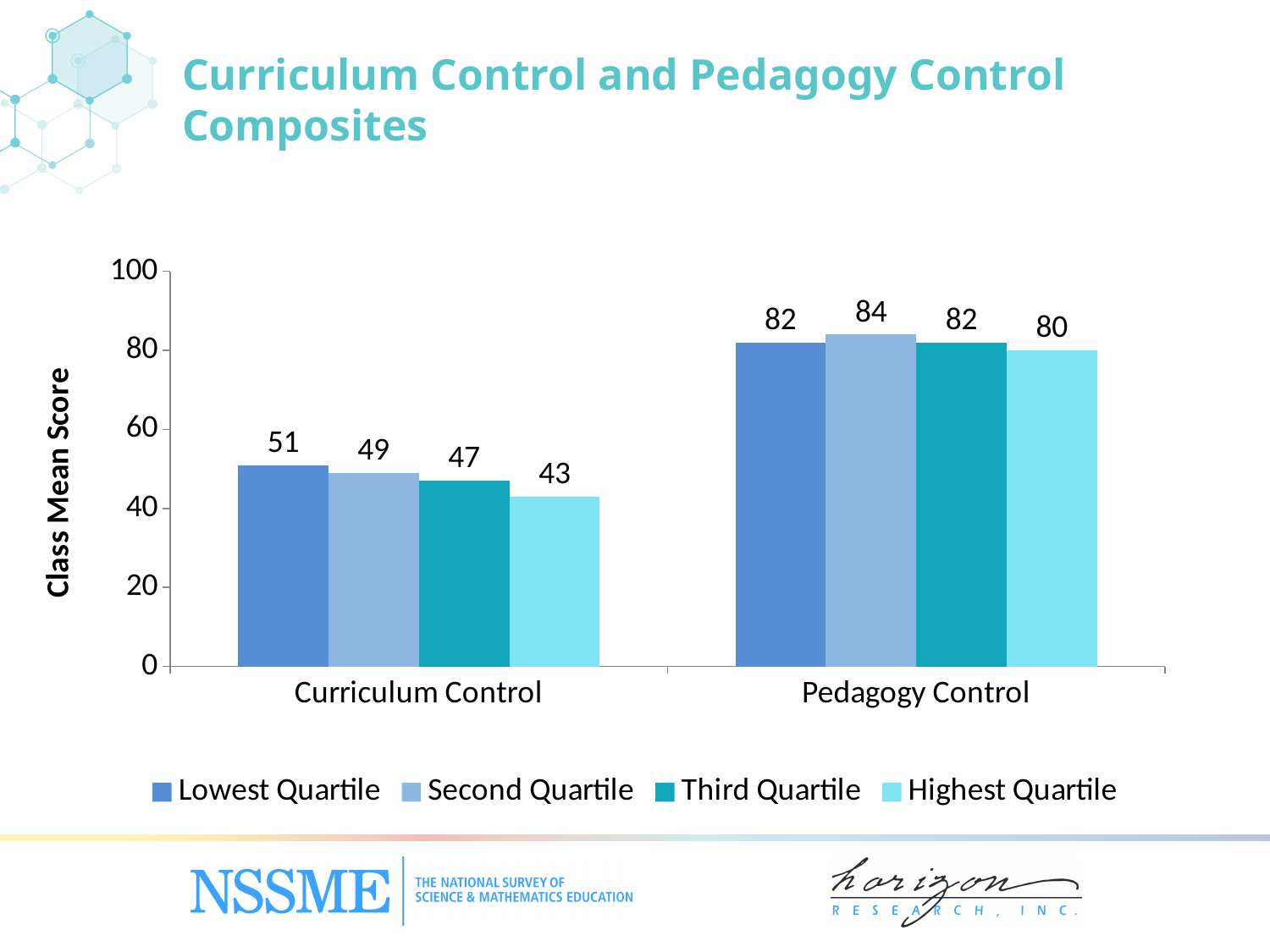
What is the class mean score for the Second Quartile on Pedagogy Control? 84 How many categories are shown on the x axis? 2 Which quartile has the lowest class mean score for Curriculum Control? Highest Quartile What kind of chart is shown on the slide? Bar chart Which quartile has the highest class mean score for Pedagogy Control? Second Quartile Is the Highest Quartile value for Curriculum Control greater or less than 60? less Which is larger: the Third Quartile score for Curriculum Control or the Third Quartile score for Pedagogy Control? Pedagogy Control What is the label of the y axis? Class Mean Score What is the class mean score for the Lowest Quartile on Curriculum Control? 51 What is the difference between the Lowest Quartile and Highest Quartile scores for Curriculum Control? 8 How many series does the legend list? 4 What is the class mean score for the Highest Quartile on Pedagogy Control? 80